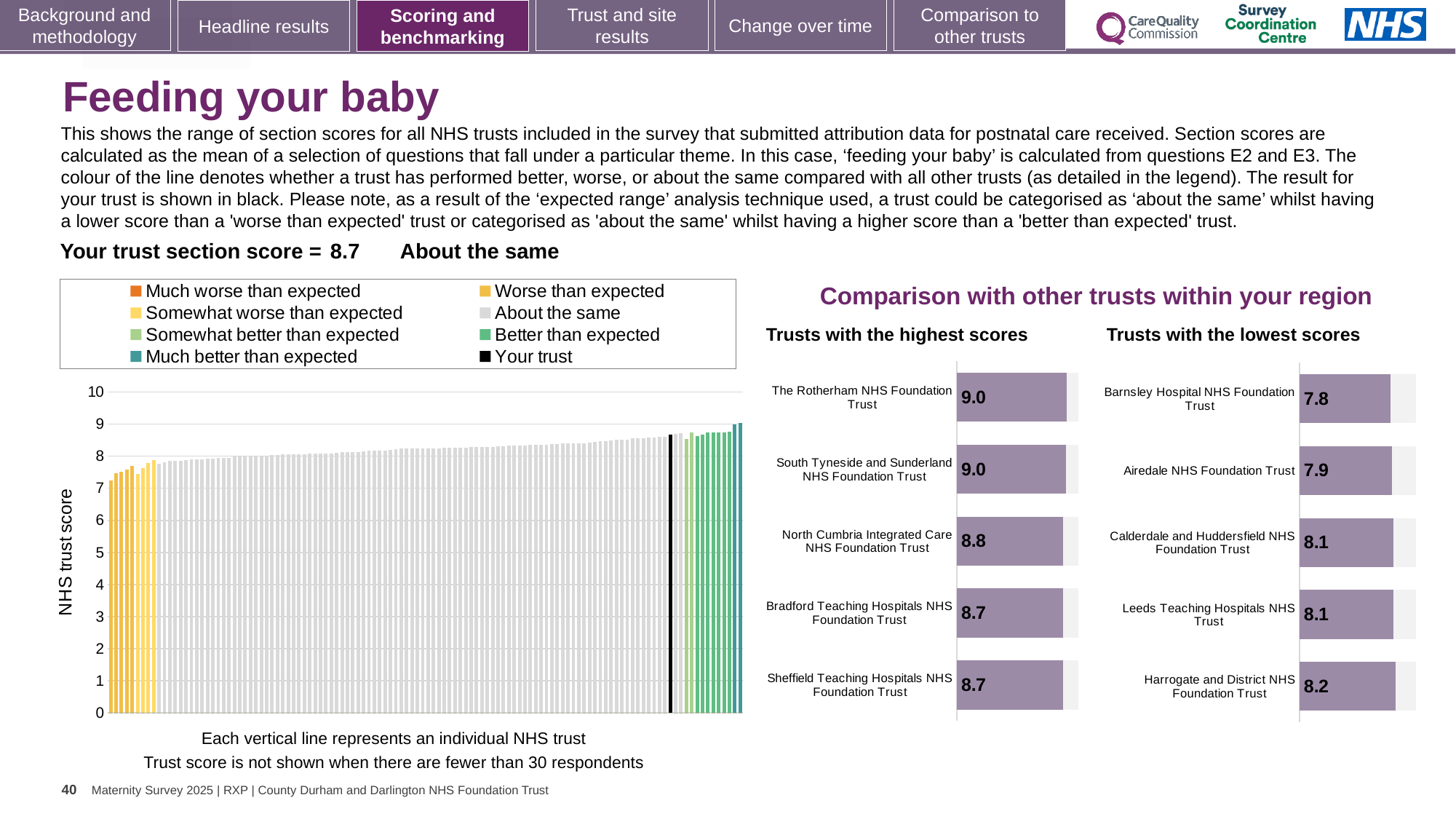
In the large 'NHS trust score' chart on the left, is the value of the leftmost (lowest) bar greater or less than 8? less In the large 'NHS trust score' chart on the left, is the value of the black 'Your trust' bar greater or less than 8? greater How many entries does the legend of the large 'NHS trust score' chart list? 8 What is the difference between The Rotherham NHS Foundation Trust's score in the 'Trusts with the highest scores' chart and Barnsley Hospital NHS Foundation Trust's score in the 'Trusts with the lowest scores' chart? 1.2 In the 'Trusts with the highest scores' chart, what is the score for North Cumbria Integrated Care NHS Foundation Trust? 8.8 In the 'Trusts with the lowest scores' chart, what is the score for Airedale NHS Foundation Trust? 7.9 How many trusts are shown in the 'Trusts with the highest scores' chart? 5 In the 'Trusts with the lowest scores' chart, which trust has the highest score? Harrogate and District NHS Foundation Trust In the 'Trusts with the lowest scores' chart, which has the larger score: Airedale NHS Foundation Trust or Calderdale and Huddersfield NHS Foundation Trust? Calderdale and Huddersfield NHS Foundation Trust What kind of chart is the large 'NHS trust score' chart on the left? bar chart In the large 'NHS trust score' chart on the left, do the bar values rise or fall from left to right? rise In the 'Trusts with the lowest scores' chart, which trust has the lowest score? Barnsley Hospital NHS Foundation Trust